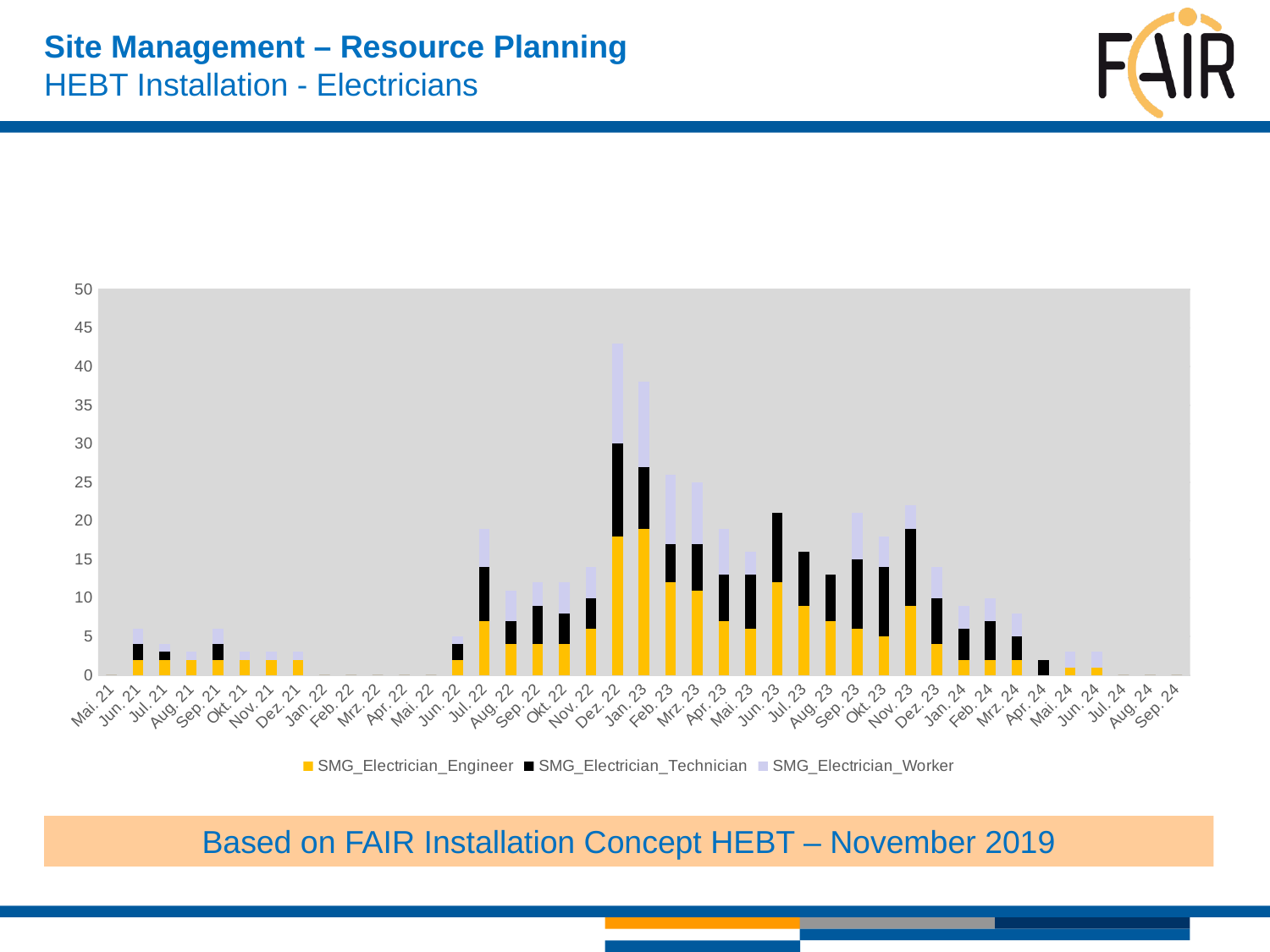
Is the total value for Jan. 23 greater or less than 35? greater What kind of chart is shown on the slide? bar chart Is the total value for Dez. 22 greater or less than 40? greater Do the total bar values generally rise or fall from Dez. 22 to Apr. 24? fall How many month categories are shown on the x axis? 41 Which month has the larger total bar, Dez. 22 or Jan. 23? Dez. 22 How many series does the legend list? 3 Is the total value for Jun. 22 greater or less than 10? less Which series is shown in yellow in the legend? SMG_Electrician_Engineer Which month has the highest total stacked bar? Dez. 22 Which month has the larger total bar, Jul. 22 or Aug. 22? Jul. 22